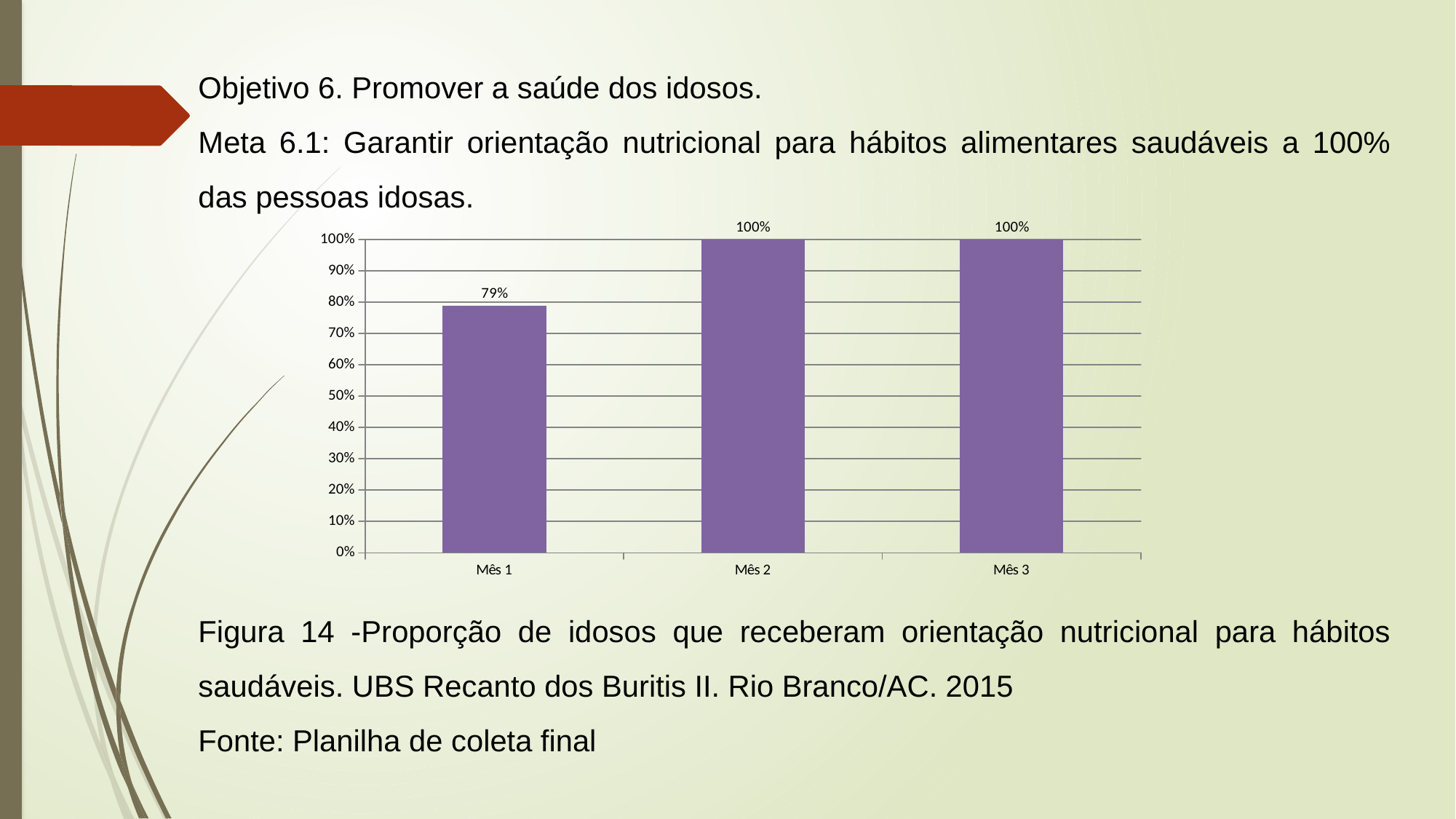
What is the difference between the values for Mês 2 and Mês 1? 21% Which is larger, the value for Mês 1 or the value for Mês 3? Mês 3 What is the value for Mês 3? 100% Which month has the lowest value? Mês 1 Is the value for Mês 1 greater or less than 70%? greater How many months are shown on the x axis? 3 What colour are the bars in the chart? purple What is the highest value shown on the y axis? 100% What is the value for Mês 1? 79% What kind of chart is shown on the slide? bar chart What is the value for Mês 2? 100% Do the values rise or fall from Mês 1 to Mês 2? rise